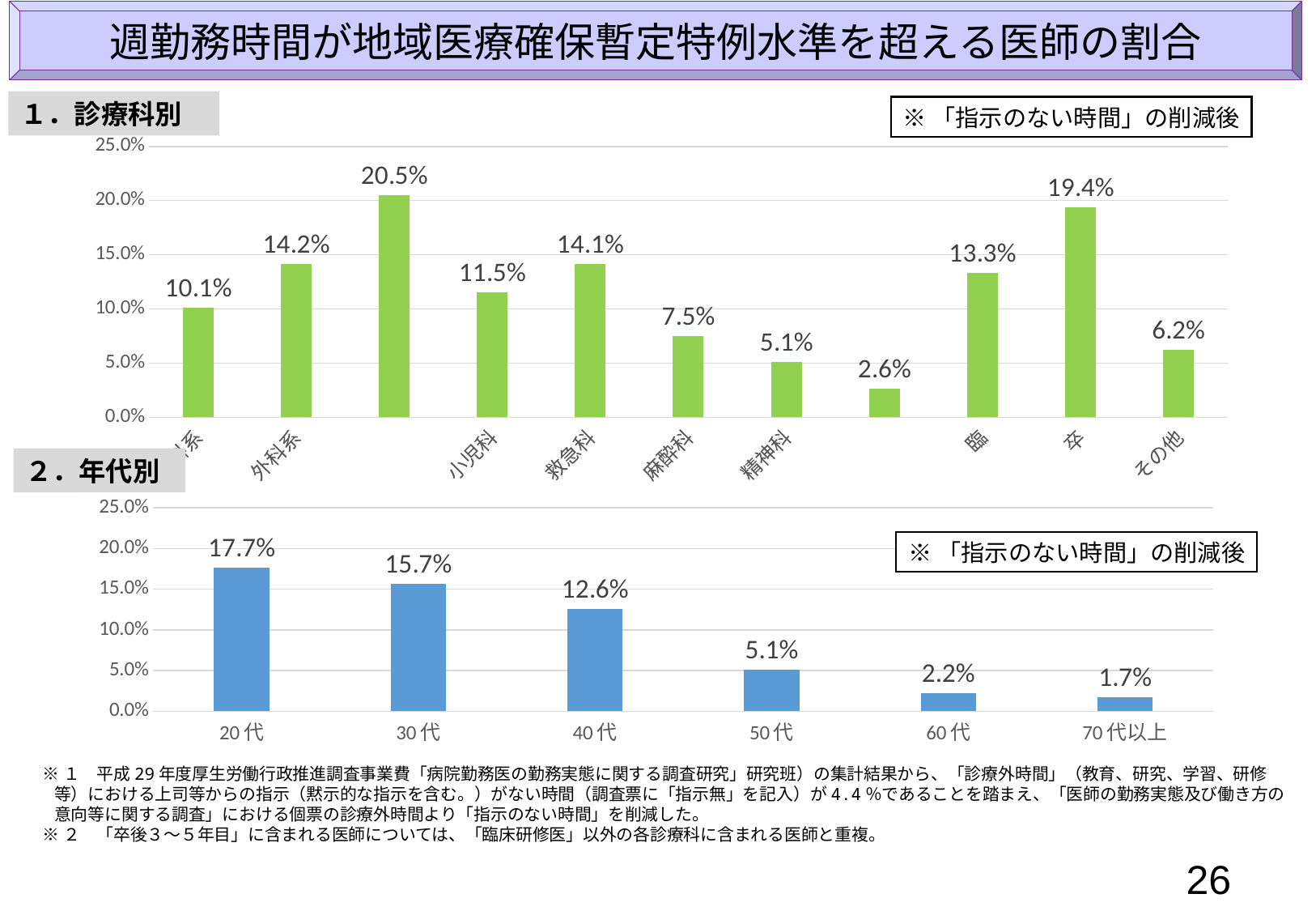
What kind of chart is the '2. 年代別' chart? bar chart In the '2. 年代別' chart, which age group has the highest value? 20代 In the '1. 診療科別' chart, what is the value for 外科系? 14.2% In the '1. 診療科別' chart, which is larger, the value for 小児科 or the value for 精神科? 小児科 In the '2. 年代別' chart, which age group has the lowest value? 70代以上 In the '1. 診療科別' chart, what is the difference between the values for 救急科 and その他? 7.9% In the '1. 診療科別' chart, what is the highest value shown on any bar? 20.5% In the '1. 診療科別' chart, what is the value for 麻酔科? 7.5% In the '1. 診療科別' chart, how many bars are plotted? 11 In the '2. 年代別' chart, do the values rise or fall as the age groups go from 20代 to 70代以上? fall In the '2. 年代別' chart, what is the difference between the values for 20代 and 50代? 12.6% In the '2. 年代別' chart, what is the value for 40代? 12.6%